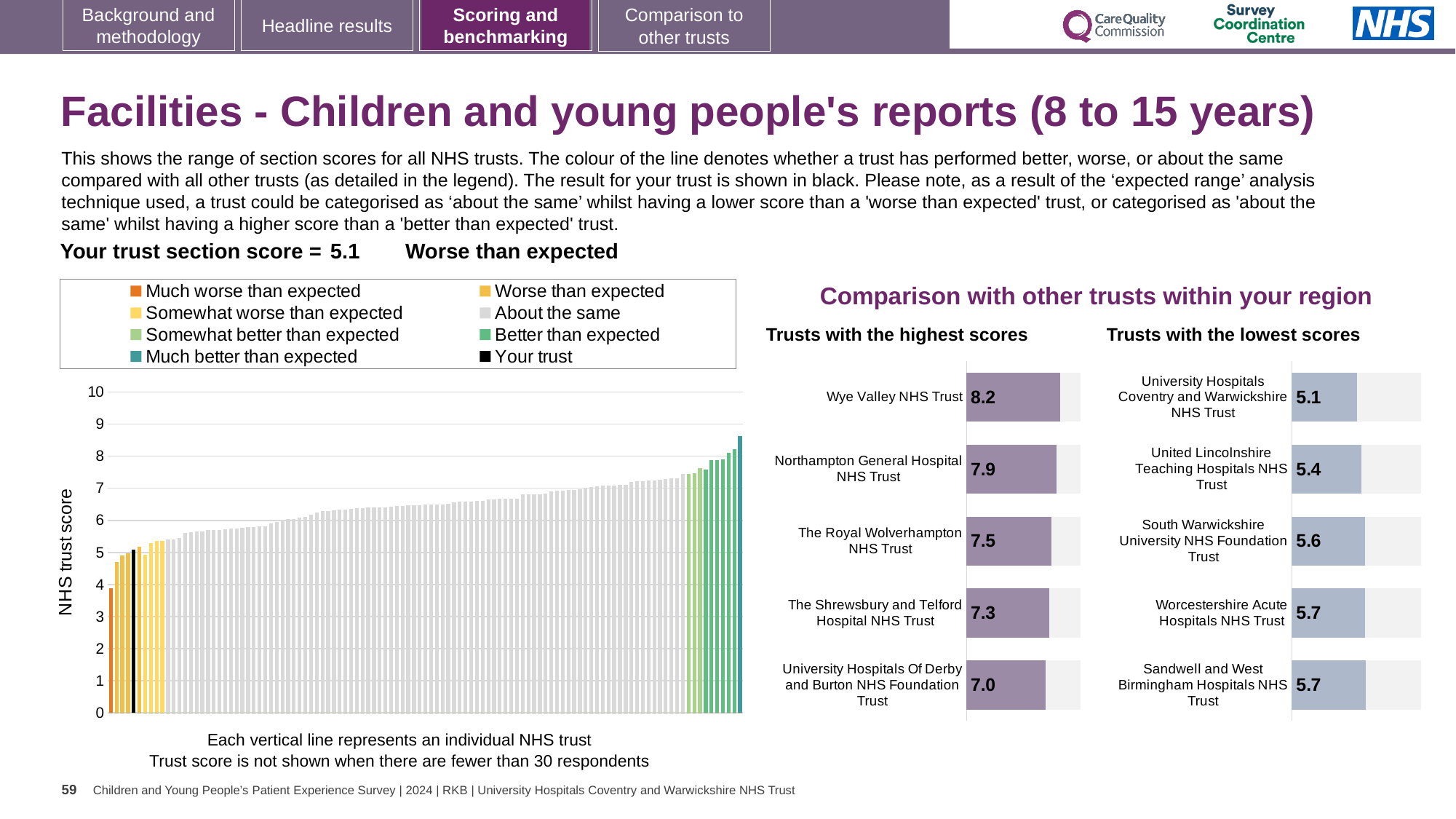
In the NHS trust score chart on the left, do the bars rise or fall from left to right? rise In the 'Trusts with the highest scores' chart, what is the difference between the scores of Wye Valley NHS Trust and Northampton General Hospital NHS Trust? 0.3 How many entries does the legend of the NHS trust score chart list? 8 In the NHS trust score chart on the left, is the value of the tallest bar greater or less than 8? greater How many trusts are listed in the 'Trusts with the lowest scores' chart? 5 In the 'Trusts with the lowest scores' chart, what is the difference between the scores of Sandwell and West Birmingham Hospitals NHS Trust and University Hospitals Coventry and Warwickshire NHS Trust? 0.6 In the 'Trusts with the highest scores' chart, what is the score for The Royal Wolverhampton NHS Trust? 7.5 In the 'Trusts with the highest scores' chart, which has a higher score: The Shrewsbury and Telford Hospital NHS Trust or The Royal Wolverhampton NHS Trust? The Royal Wolverhampton NHS Trust In the 'Trusts with the lowest scores' chart, which trust has the lowest score? University Hospitals Coventry and Warwickshire NHS Trust In the 'Trusts with the lowest scores' chart, what is the score for United Lincolnshire Teaching Hospitals NHS Trust? 5.4 In the 'Trusts with the highest scores' chart, what is the score for Wye Valley NHS Trust? 8.2 In the 'Trusts with the highest scores' chart, which trust has the lowest score shown? University Hospitals Of Derby and Burton NHS Foundation Trust